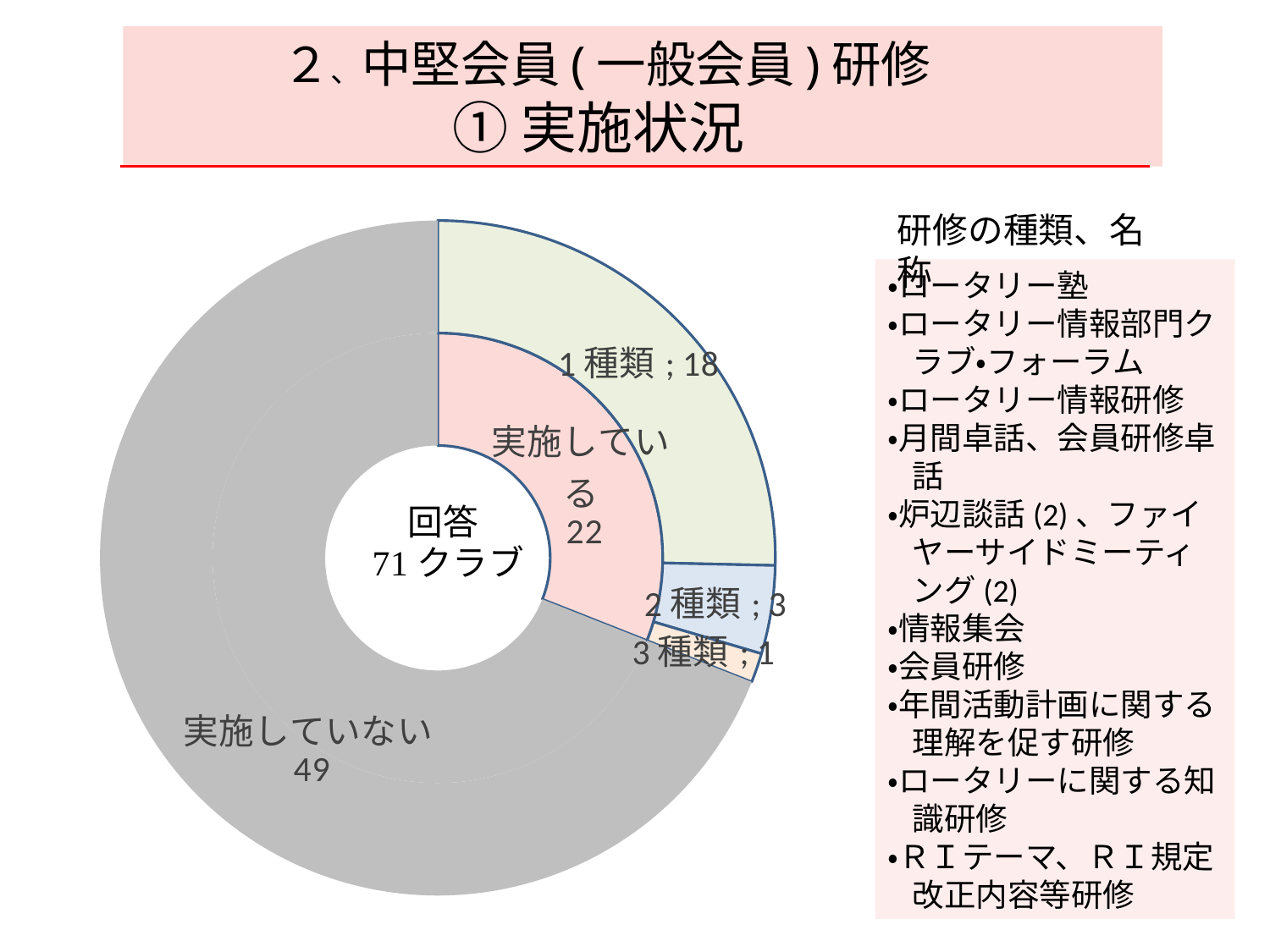
What is the difference between the values for 実施していない and 実施している? 27 What text is written in the centre of the doughnut chart? 回答 71クラブ What value is shown for 2種類 in the outer ring? 3 How many clubs are labelled as 1種類 in the outer ring? 18 Among 1種類, 2種類 and 3種類, which has the lowest value? 3種類 What is the total of 実施している and 実施していない in the inner ring? 71 What value is shown for 実施している in the inner ring of the doughnut chart? 22 Among 1種類, 2種類 and 3種類, which has the highest value? 1種類 Which is larger, the value for 1種類 or the value for 2種類? 1種類 What value is shown for 3種類 in the outer ring? 1 What value is shown for 実施していない in the doughnut chart? 49 What kind of chart is shown on the slide? Doughnut chart